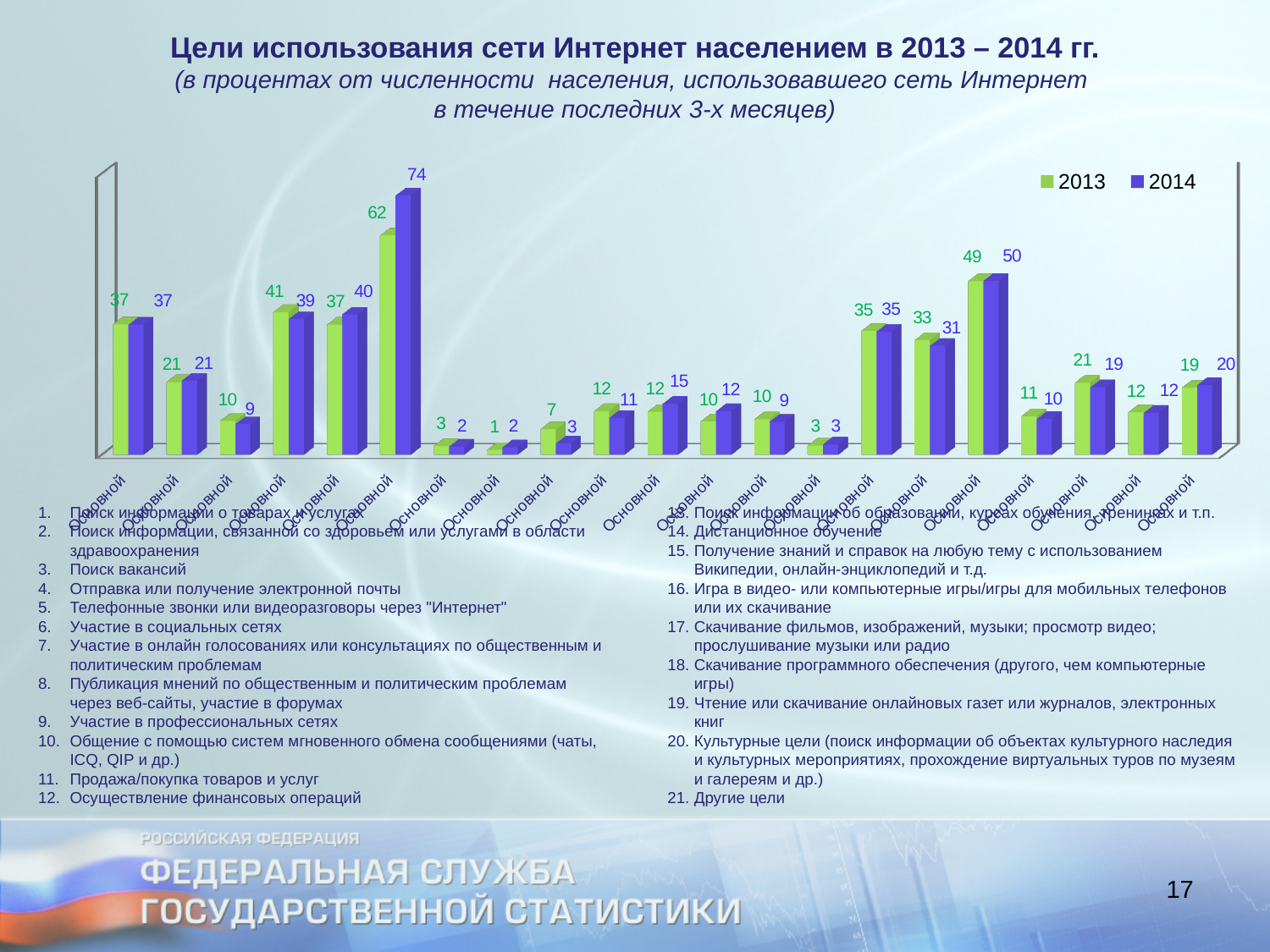
What is the highest 2014 value shown on the chart? 74 For the sixth category from the left, how much higher is the 2014 value than the 2013 value? 12 What is the 2013 value for the sixth category from the left (item 6 in the list, participation in social networks)? 62 What is the 2014 value for the first category from the left (item 1 in the list)? 37 What is the lowest 2013 value shown on the chart? 1 For the fourth category from the left, what is the difference between the 2013 value and the 2014 value? 2 How many series does the chart legend list? 2 What are the two series named in the chart legend? 2013 and 2014 What kind of chart is shown on the slide? Bar chart How many categories (bar groups) are plotted on the chart? 21 What is the 2014 value for the seventeenth category from the left (item 17 in the list)? 50 For the fifth category from the left, which year has the larger value, 2013 or 2014? 2014